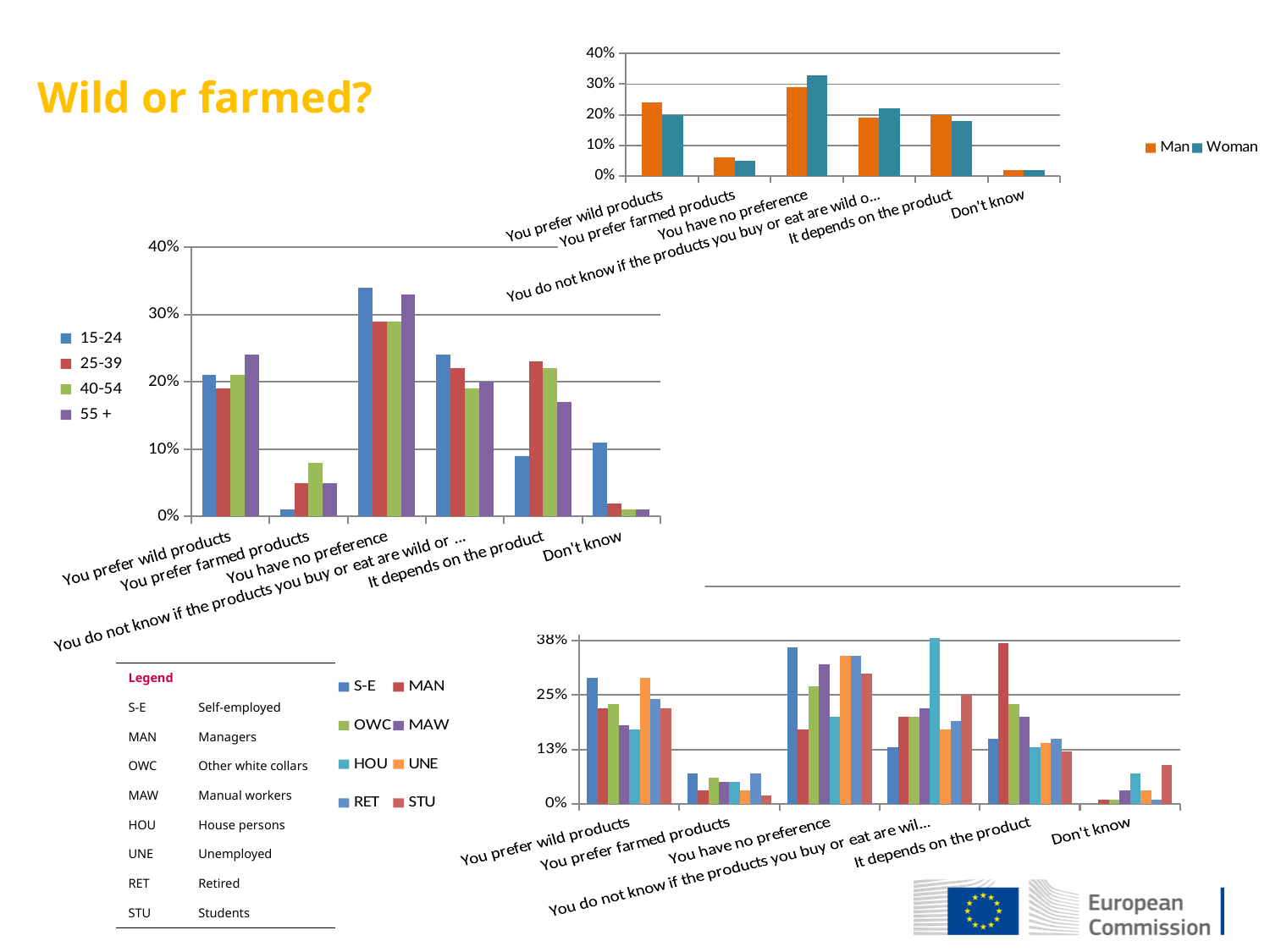
In the top-right chart, which category has the lowest value for Man? Don't know In the top-right chart, for 'You prefer wild products', which is larger, Man or Woman? Man In the bottom-right chart, how many series does the legend list? 8 In the top-right chart, which category has the highest value for Woman? You have no preference In the left chart, for 'Don't know', which group has the largest value? 15-24 In the left chart, how many series does the legend list? 4 In the left chart, how many categories are shown on the x axis? 6 What type of chart is the bottom-right chart? Bar chart In the top-right chart, how many series does the legend list? 2 In the top-right chart, is the value for Woman for 'You have no preference' greater or less than 30%? greater In the left chart, which category has the highest value for the 15-24 group? You have no preference In the left chart, is the value for the 15-24 group for 'You have no preference' greater or less than 30%? greater